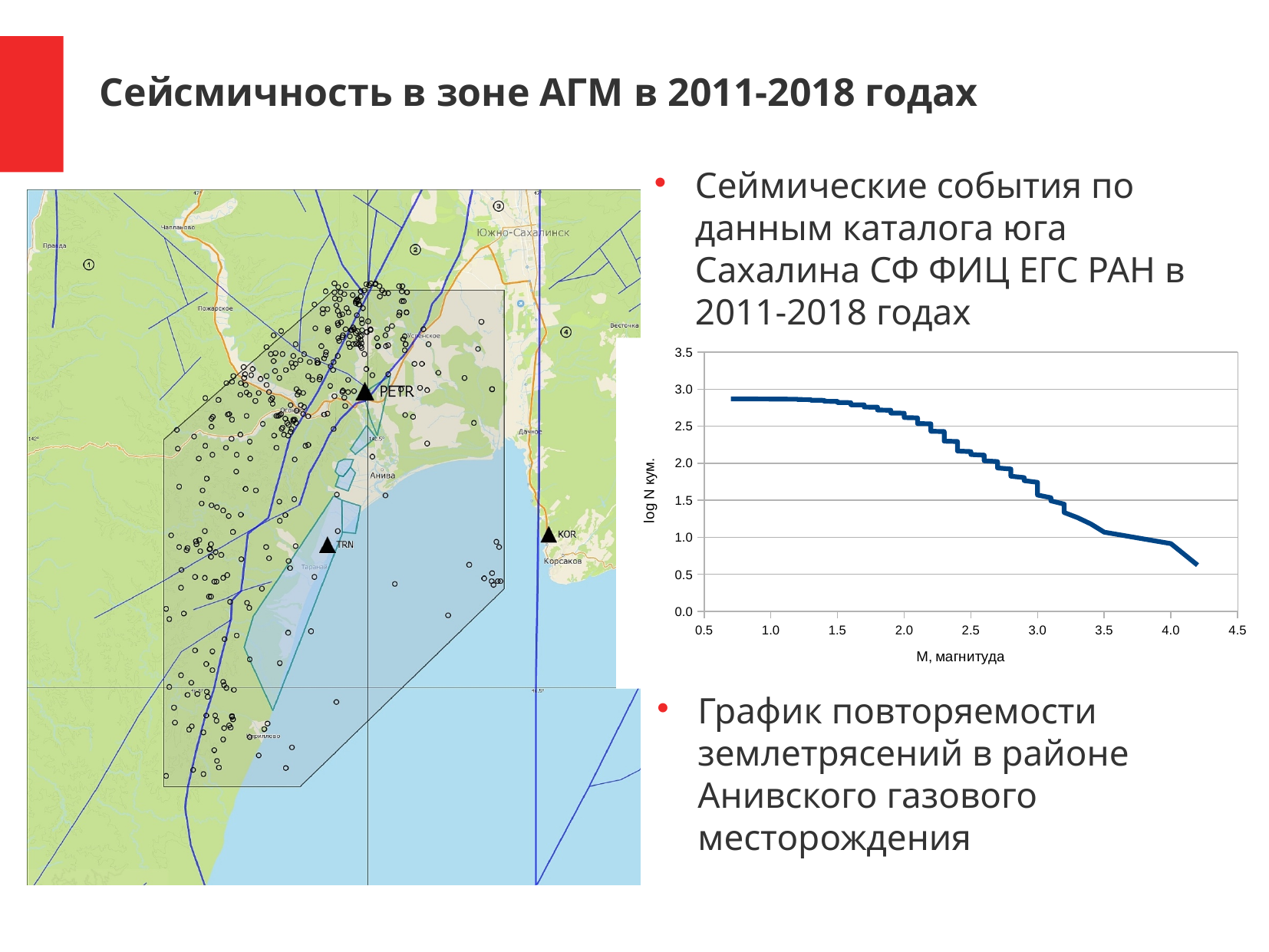
In the chart on the right, is the value of log N at magnitude 1.0 greater or less than 2.0? greater In the chart on the right, do the values rise or fall as magnitude increases along the x axis? fall What is the label of the x axis of the chart on the right? М, магнитуда In the chart on the right, is the value of log N at magnitude 3.5 greater or less than 1.5? less What kind of chart is shown on the right side of the slide? line chart In the chart on the right, is the value at magnitude 1.0 larger or smaller than the value at magnitude 3.0? larger In the chart on the right, is the value of log N at magnitude 3.0 greater or less than 2.0? less What is the label of the y axis of the chart on the right? log N кум.